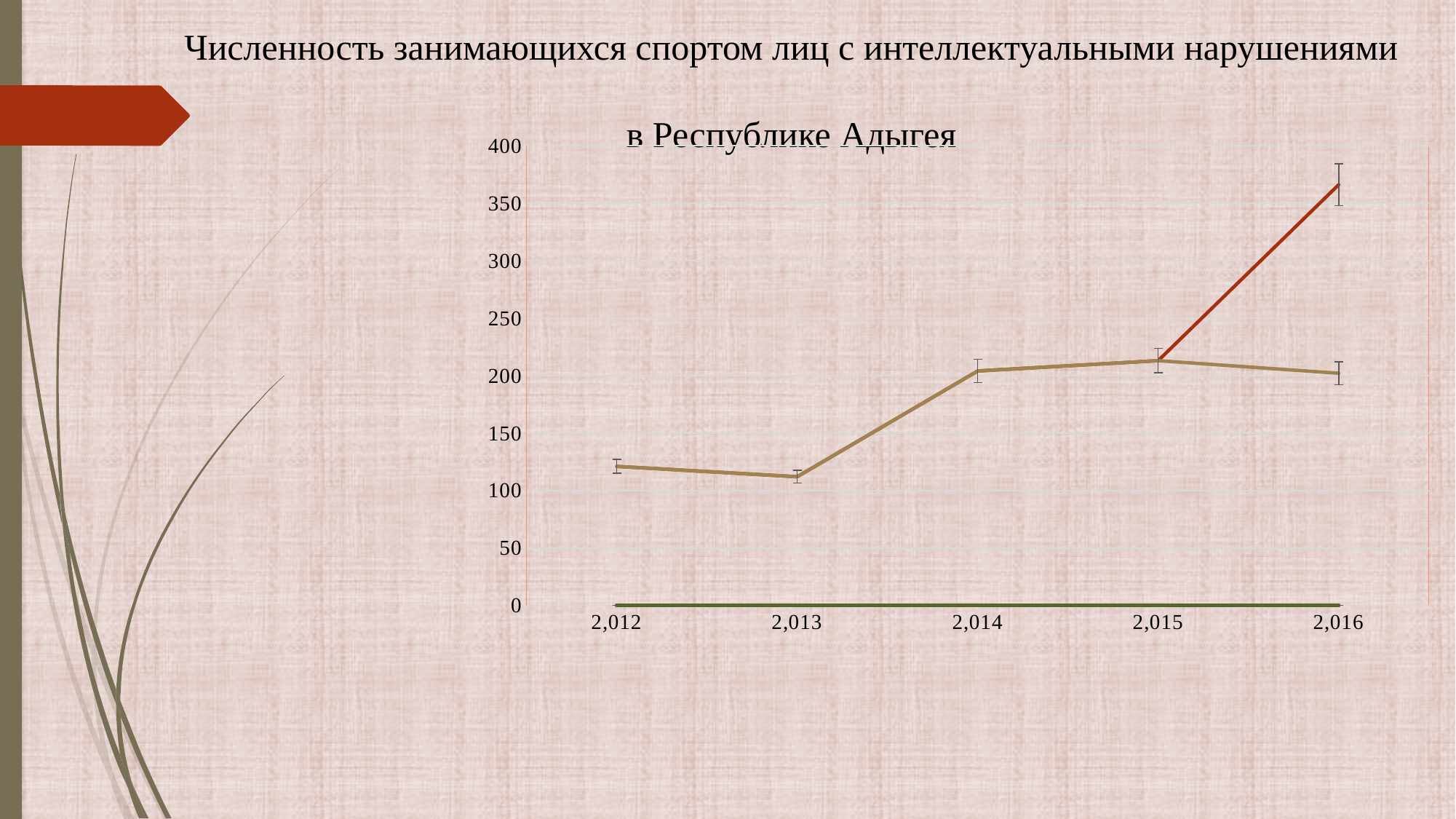
In which year does the tan line reach its lowest value? 2,013 What kind of chart is shown on the slide? line chart In which year does the red line reach its highest value? 2,016 Is the value of the tan line for 2,013 greater or less than 150? less Which is larger in 2,016: the value of the red line or the value of the tan line? the red line Is the value of the tan line for 2,012 greater or less than 100? greater What is the title of the chart on the slide? Численность занимающихся спортом лиц с интеллектуальными нарушениями в Республике Адыгея Is the value of the red line for 2,016 greater or less than 300? greater Does the tan line rise or fall between 2,013 and 2,014? rise How many years are shown along the x axis of the chart? 5